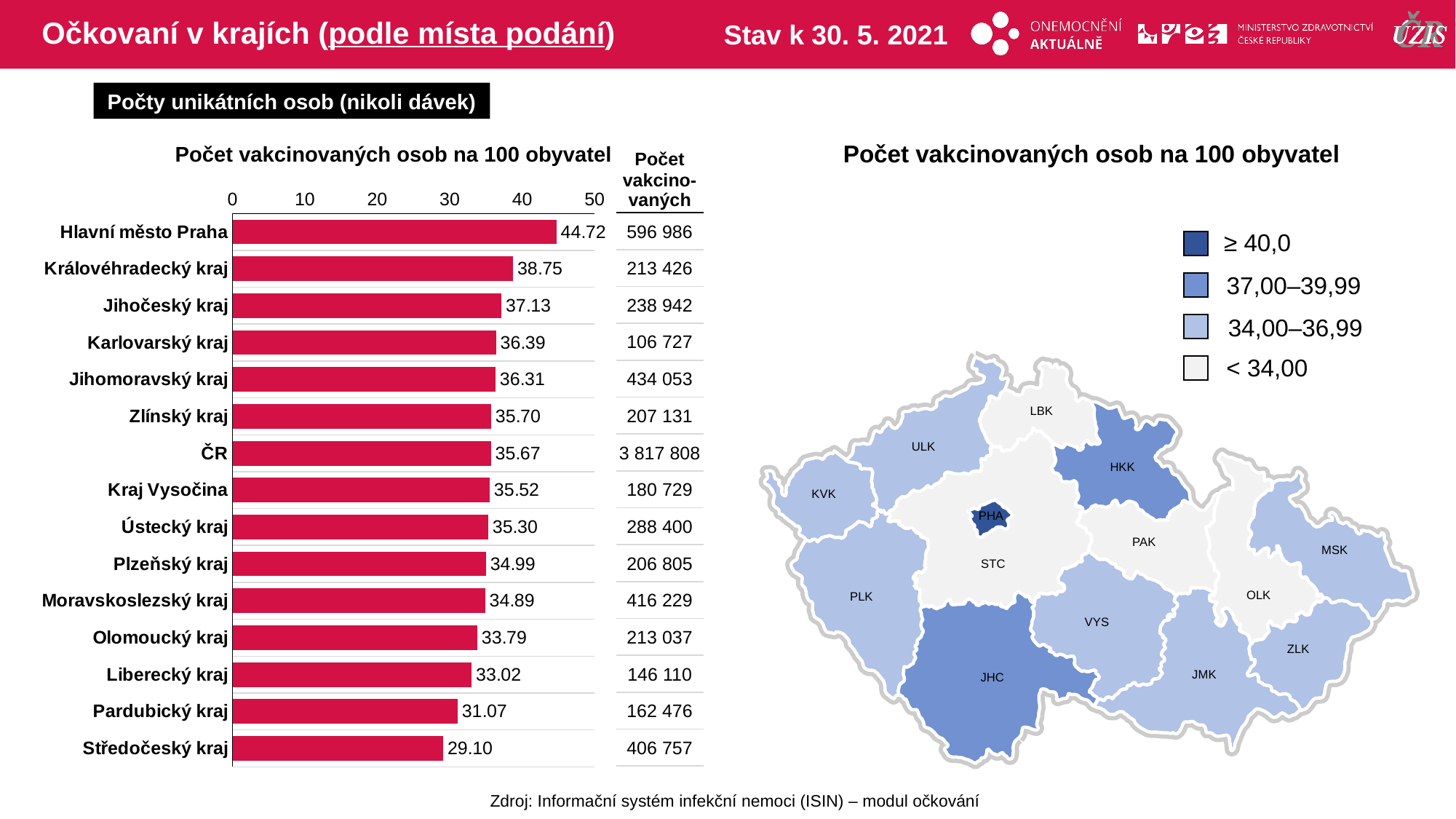
In the bar chart, what is the value for Hlavní město Praha? 44.72 How many bars does the bar chart show? 15 In the bar chart, which region has the highest number of vaccinated persons per 100 inhabitants? Hlavní město Praha In the bar chart, which has a larger value, Královéhradecký kraj or Liberecký kraj? Královéhradecký kraj In the map legend, what range does the darkest blue colour represent? ≥ 40,0 In the bar chart, what is the value for Jihomoravský kraj? 36.31 In the bar chart, which region has the lowest number of vaccinated persons per 100 inhabitants? Středočeský kraj What is the title of the bar chart on the left? Počet vakcinovaných osob na 100 obyvatel In the bar chart, what is the difference between the values for Hlavní město Praha and Středočeský kraj? 15.62 In the bar chart, is the value for Pardubický kraj greater or less than 30? greater What kind of chart is shown on the left of the slide? bar chart In the bar chart, what is the value for ČR? 35.67